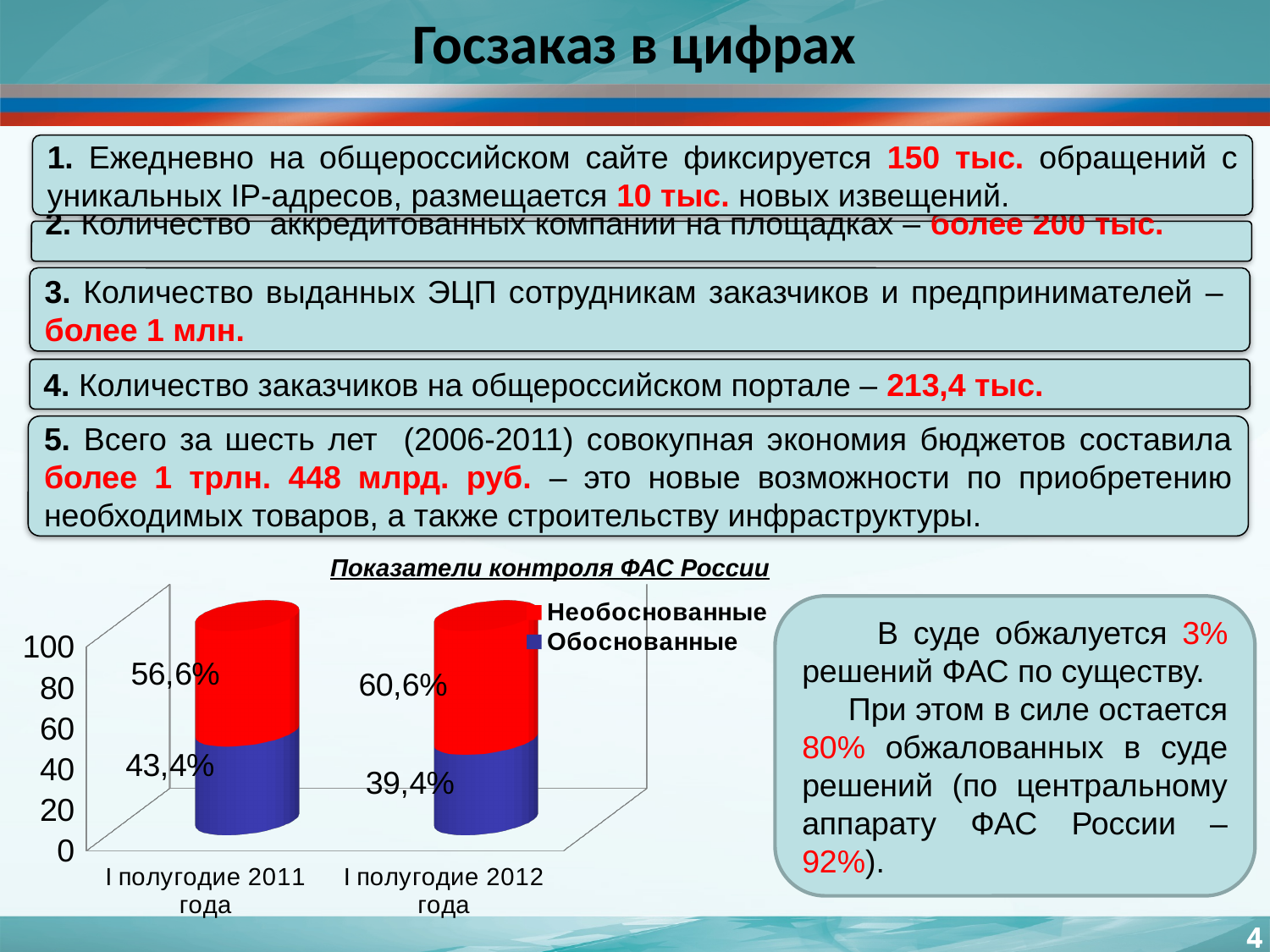
What is the value for Обоснованные in I полугодие 2011 года? 43,4% What is the value for Необоснованные in I полугодие 2011 года? 56,6% How many categories (periods) are shown on the x axis? 2 What is the value for Обоснованные in I полугодие 2012 года? 39,4% What kind of chart is shown? Stacked bar chart How many series does the legend list? 2 In which period is the Необоснованные share higher? I полугодие 2012 года What is the title of the chart? Показатели контроля ФАС России In which period is the Обоснованные share lower? I полугодие 2012 года Which is larger in I полугодие 2011 года: Обоснованные or Необоснованные? Необоснованные What is the value for Необоснованные in I полугодие 2012 года? 60,6% What is the difference between the Необоснованные values for I полугодие 2012 года and I полугодие 2011 года? 4 percentage points